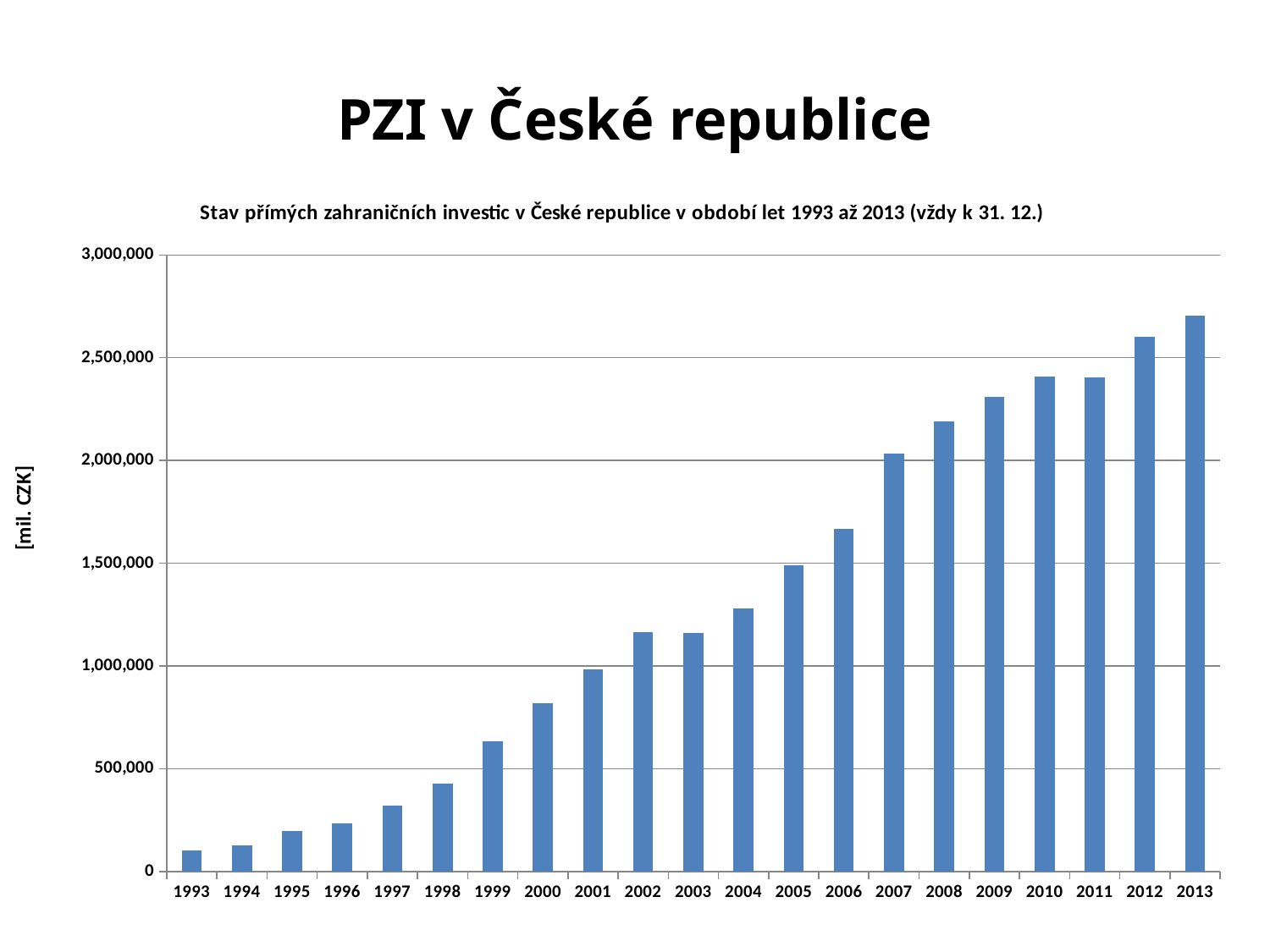
Is the value for 2006 greater or less than 2,000,000? less Do the values generally rise or fall from 1993 to 2013? rise Which year has the lowest value in the chart? 1993 Which year has the larger value, 2008 or 2012? 2012 Which year has the highest value in the chart? 2013 How many years (bars) are shown in the chart? 21 Is the value for 2009 greater or less than 2,000,000? greater Is the value for 2004 greater or less than 1,500,000? less What kind of chart is shown on the slide? bar chart What unit is shown on the vertical axis label? [mil. CZK]